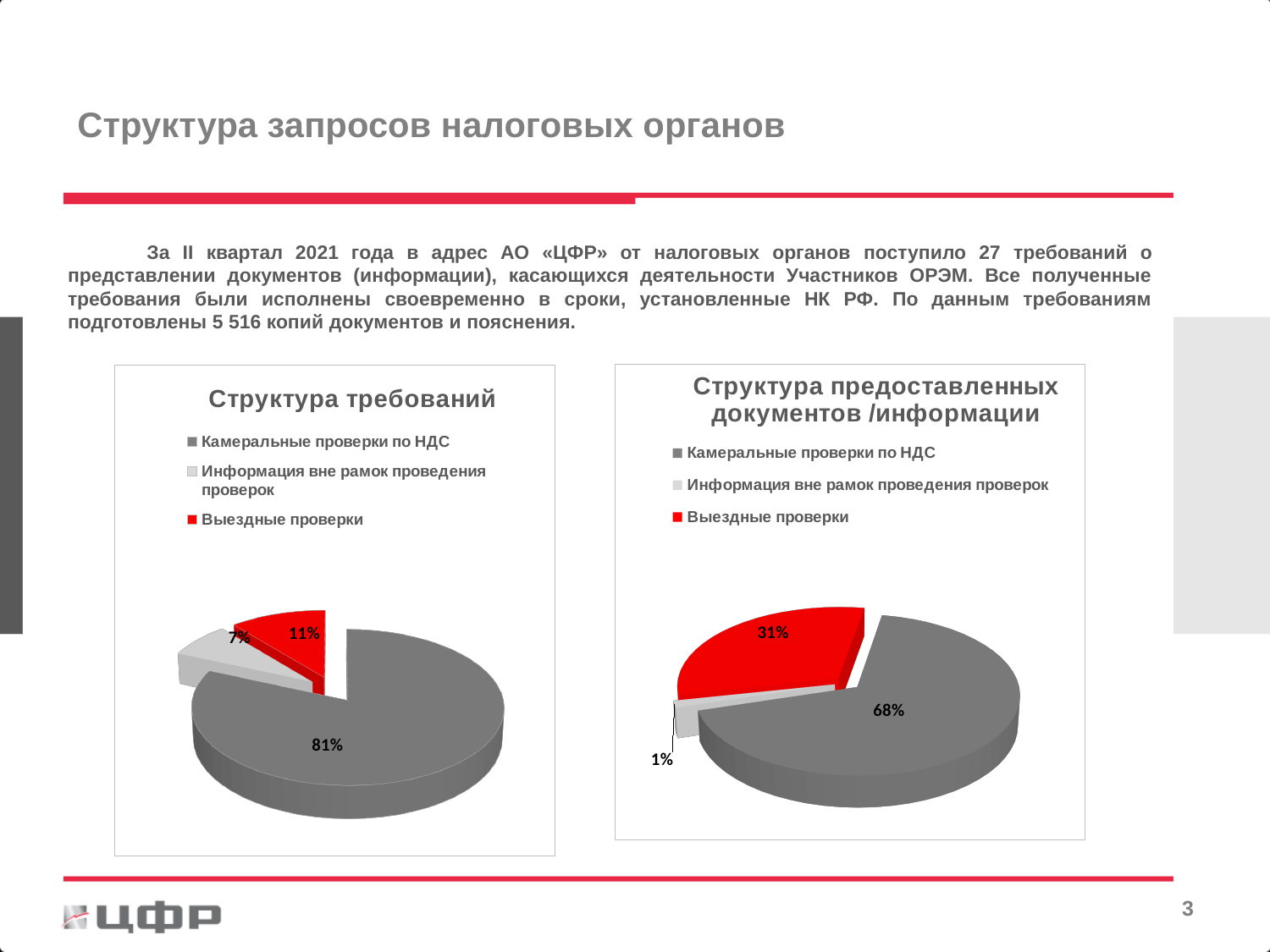
In the chart titled «Структура требований», which category has the largest slice? Камеральные проверки по НДС In the chart titled «Структура предоставленных документов /информации», what share is shown for «Выездные проверки»? 31% In the chart titled «Структура требований», what share is shown for «Выездные проверки»? 11% How many categories does the legend of the chart titled «Структура предоставленных документов /информации» list? 3 In the chart titled «Структура требований», what share is shown for «Информация вне рамок проведения проверок»? 7% In the chart titled «Структура предоставленных документов /информации», which is larger: «Выездные проверки» or «Информация вне рамок проведения проверок»? Выездные проверки In the chart titled «Структура предоставленных документов /информации», which category has the smallest slice? Информация вне рамок проведения проверок In the chart titled «Структура требований», what is the difference in percentage points between «Камеральные проверки по НДС» and «Выездные проверки»? 70 In the chart titled «Структура требований», what share is shown for «Камеральные проверки по НДС»? 81% In the chart titled «Структура требований», what colour is the slice for «Выездные проверки»? Red What type of chart is the chart titled «Структура требований»? Pie chart In the chart titled «Структура предоставленных документов /информации», what share is shown for «Камеральные проверки по НДС»? 68%